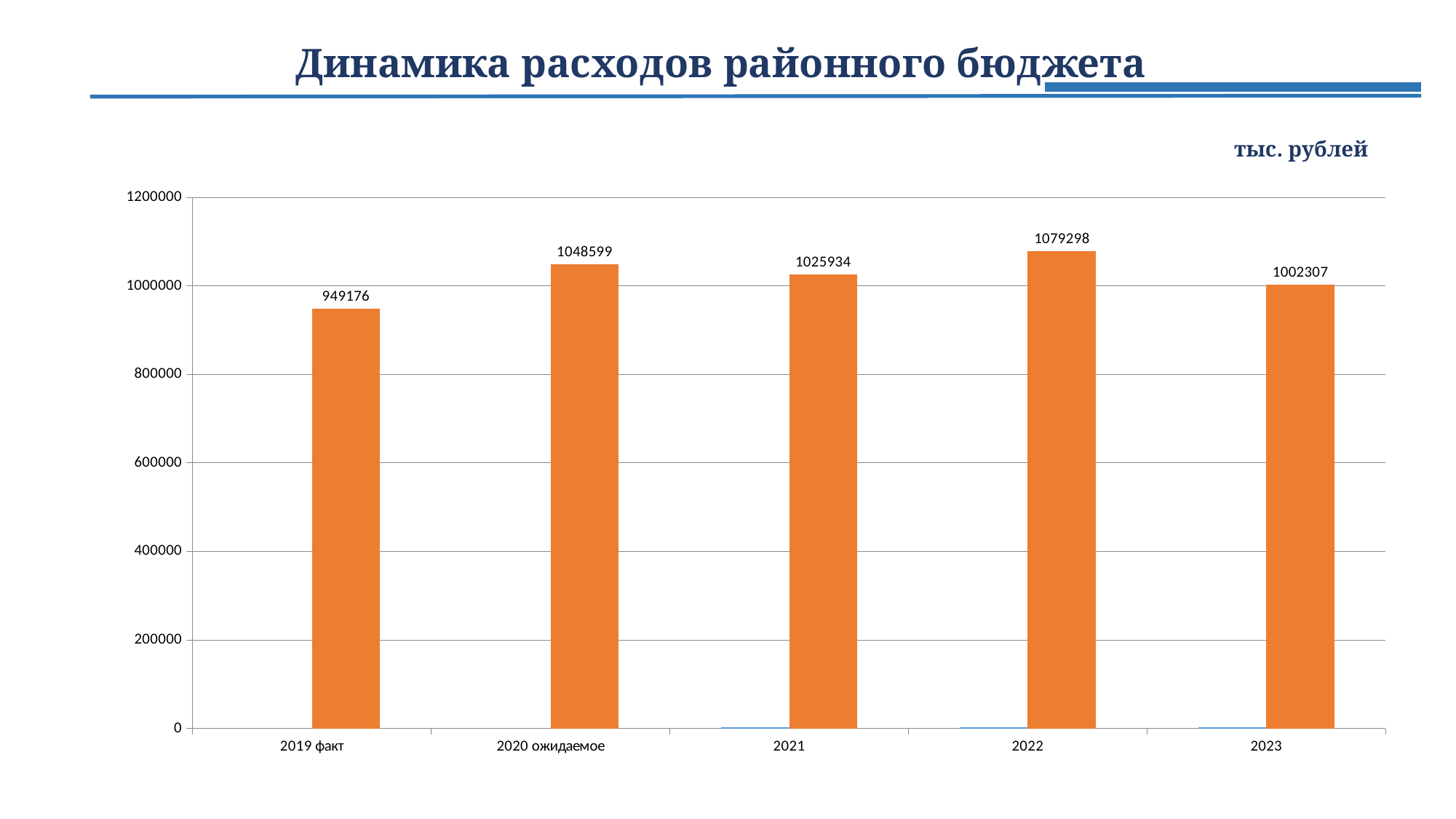
What is the difference between the values for 2021 and 2023? 23627 What kind of chart is shown on the slide? bar chart What is the value for 2023? 1002307 Which is larger, the value for 2020 ожидаемое or the value for 2021? 2020 ожидаемое What is the difference between the values for 2022 and 2019 факт? 130122 What is the value for 2022? 1079298 How many categories are shown on the x axis? 5 Is the value for 2019 факт greater or less than 1000000? less What is the value for 2020 ожидаемое? 1048599 Which category has the highest value? 2022 Which category has the lowest value? 2019 факт What is the value for 2019 факт? 949176